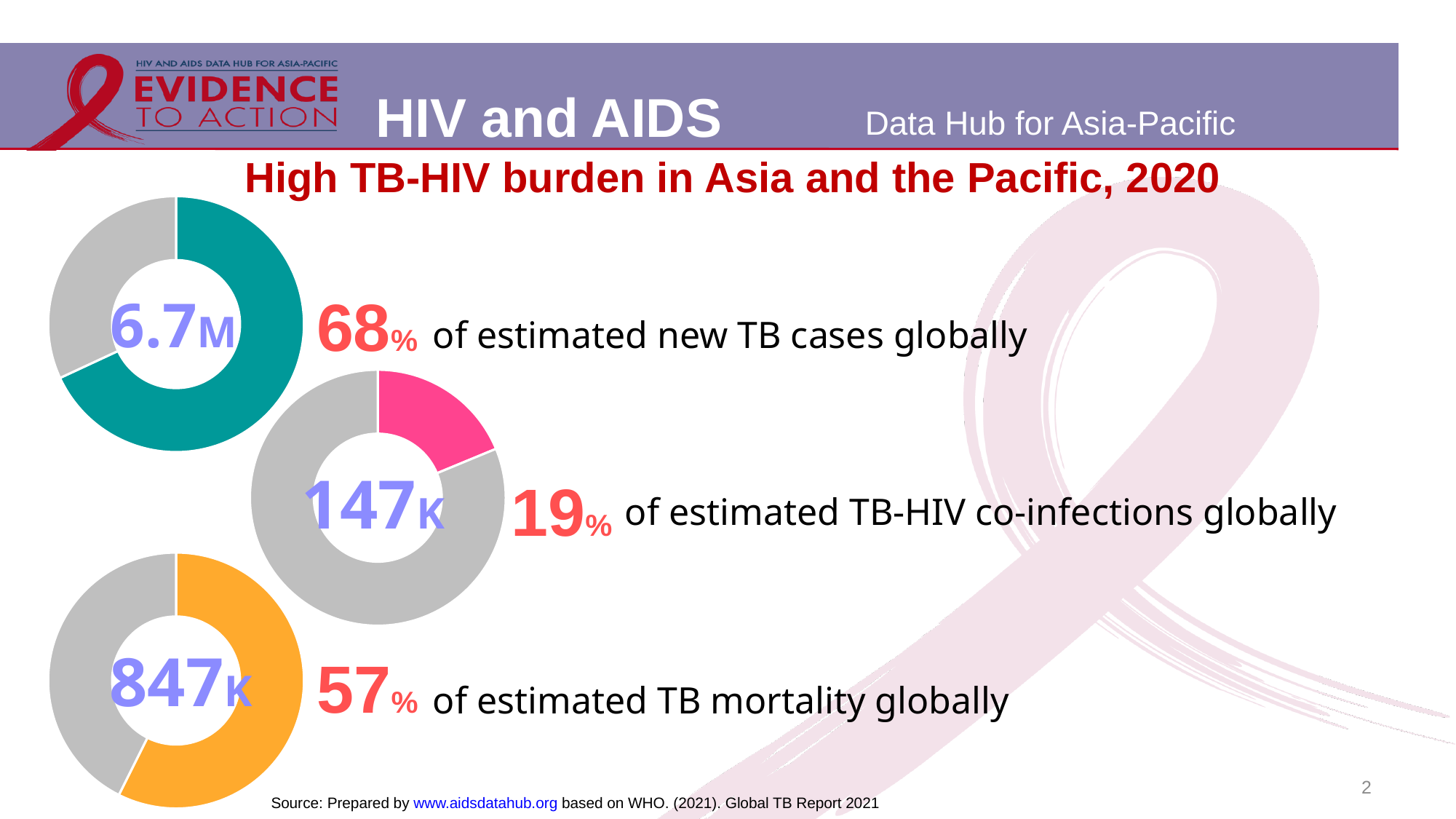
How many donut charts are shown on the slide? 3 What number is shown in the centre of the middle donut chart (estimated TB-HIV co-infections)? 147K Across the three donut charts, which indicator has the highest regional share of the global total? Estimated new TB cases (68%) Across the three donut charts, which indicator has the lowest regional share of the global total? Estimated TB-HIV co-infections (19%) In the top donut chart, what percentage of estimated new TB cases globally does Asia and the Pacific account for? 68% What number is shown in the centre of the top donut chart (estimated new TB cases)? 6.7M What colour is the highlighted segment in the middle donut chart (TB-HIV co-infections)? Pink In the bottom donut chart, what percentage of estimated TB mortality globally does Asia and the Pacific account for? 57% Which is larger: the regional share of TB mortality (bottom chart) or the regional share of TB-HIV co-infections (middle chart)? TB mortality (57%) What is the difference in percentage points between the share of new TB cases (top chart) and the share of TB-HIV co-infections (middle chart)? 49 percentage points In the middle donut chart, what percentage of estimated TB-HIV co-infections globally does Asia and the Pacific account for? 19% What number is shown in the centre of the bottom donut chart (estimated TB mortality)? 847K